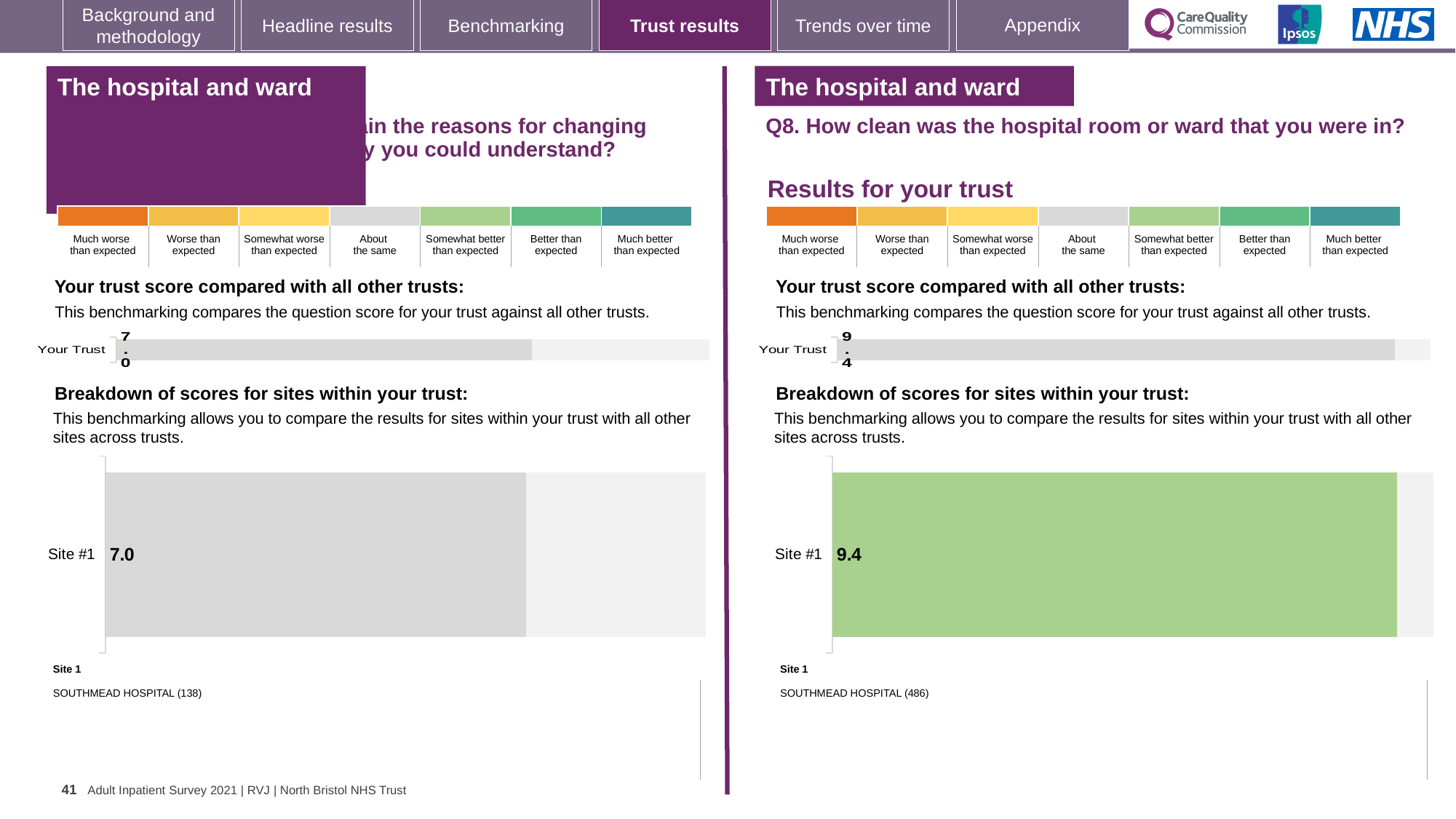
On the left-hand panel, what is the score shown for Site #1 in the breakdown of scores for sites within your trust? 7.0 How many sites are shown in the breakdown of scores chart on the left-hand panel? 1 On the right-hand panel (Q8), what is the score shown for Site #1 in the breakdown of scores for sites within your trust? 9.4 What is the difference between the Site #1 score on the right-hand panel (Q8) and the Site #1 score on the left-hand panel? 2.4 On the right-hand panel (Q8. How clean was the hospital room or ward that you were in?), what is the score shown for Your Trust? 9.4 Is the Your Trust score on the right-hand panel (Q8) greater or less than 9? greater Which is larger: the Site #1 score on the left-hand panel or the Site #1 score on the right-hand panel (Q8)? Right-hand panel (Q8) How many sites are shown in the breakdown of scores chart on the right-hand panel (Q8)? 1 On the left-hand panel, what is the score shown for Your Trust? 7.0 What kind of chart is used to show the Site #1 score on the right-hand panel (Q8)? Bar chart On the left-hand panel, which site name is listed as Site 1 below the breakdown chart? SOUTHMEAD HOSPITAL (138) On the right-hand panel (Q8), which site name is listed as Site 1 below the breakdown chart? SOUTHMEAD HOSPITAL (486)